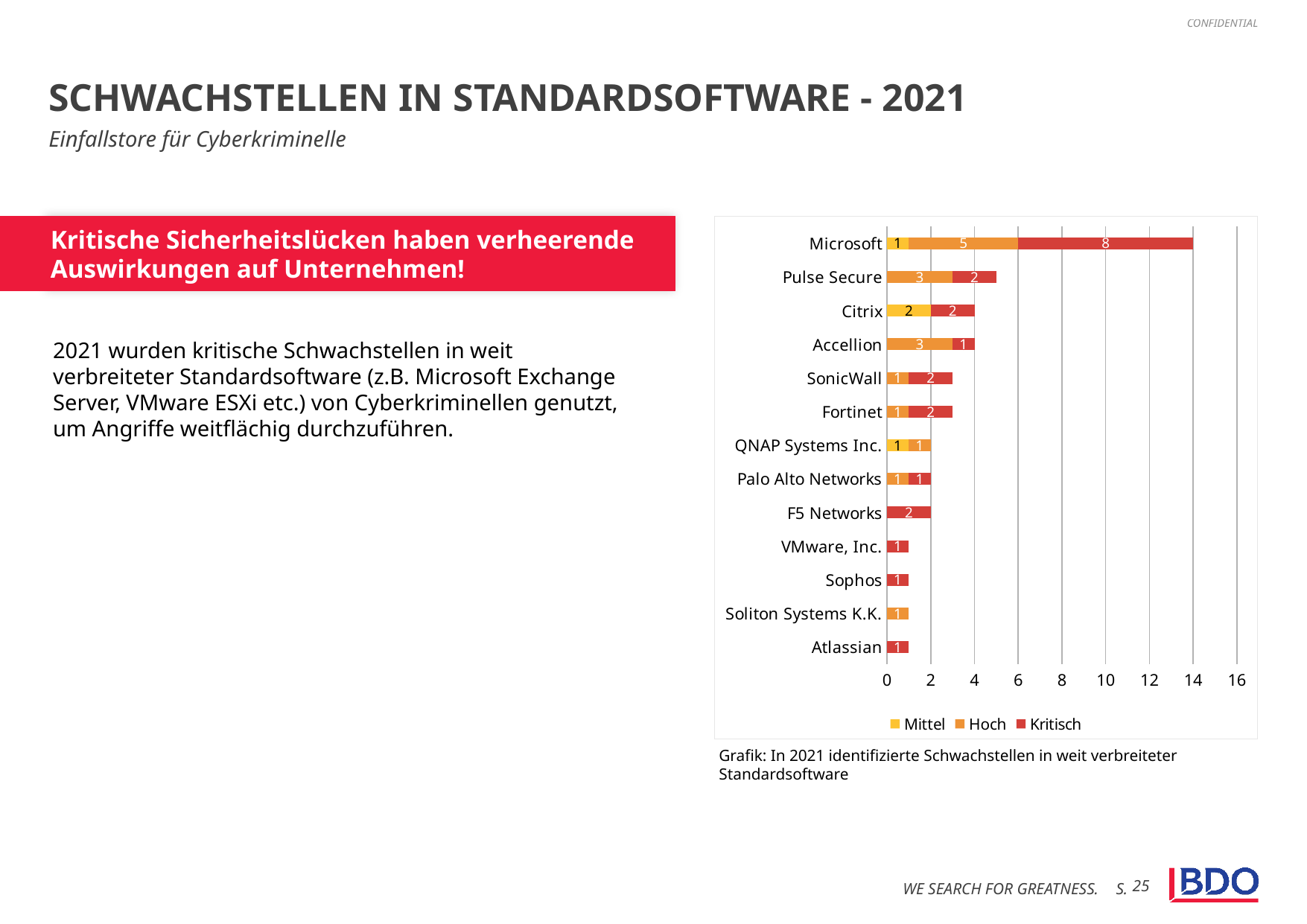
Which series is shown in red in the legend? Kritisch How many series does the legend list? 3 What is the total number of vulnerabilities for Microsoft? 14 What is the difference between the Kritisch value for Microsoft and the Kritisch value for Pulse Secure? 6 What is the Hoch value for Pulse Secure? 3 How many software vendors (categories) are shown in the chart? 13 Which vendor has the highest total number of vulnerabilities? Microsoft What is the Kritisch value for Microsoft? 8 What is the total number of vulnerabilities for Pulse Secure? 5 What kind of chart is shown on the slide? Stacked bar chart What is the Mittel value for Citrix? 2 Which is larger, the Hoch value for Accellion or the Hoch value for SonicWall? Accellion